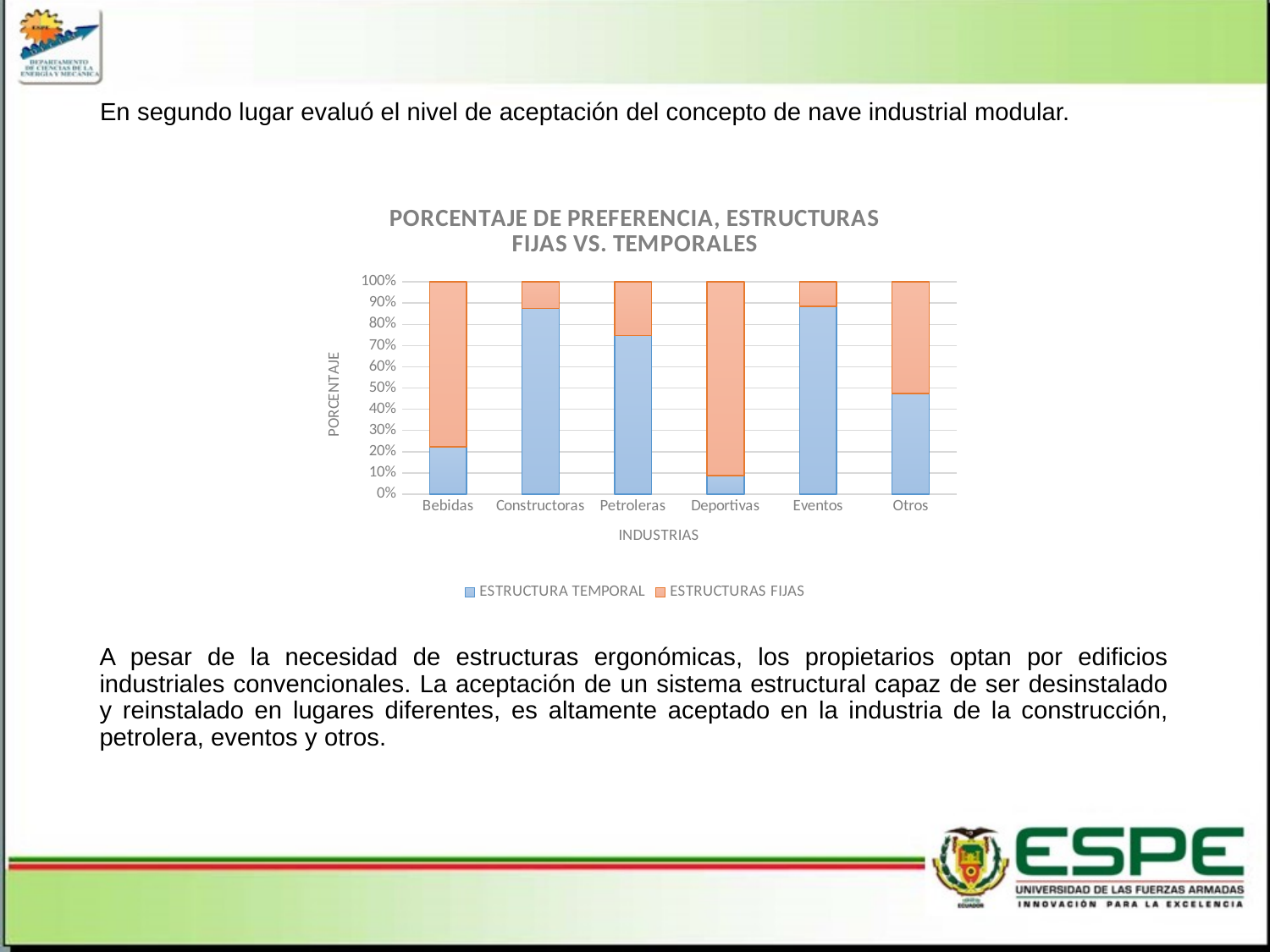
Is the ESTRUCTURA TEMPORAL share for Bebidas greater or less than 30%? less Is the ESTRUCTURA TEMPORAL share for Otros greater or less than 40%? greater Which industry has the highest share of ESTRUCTURAS FIJAS? Deportivas How many series does the chart legend list? 2 What is the title of the chart? PORCENTAJE DE PREFERENCIA, ESTRUCTURAS FIJAS VS. TEMPORALES Is the ESTRUCTURA TEMPORAL share for Constructoras greater or less than 80%? greater What kind of chart is shown on the slide? Stacked bar chart Which has a larger ESTRUCTURA TEMPORAL share, Bebidas or Petroleras? Petroleras What is the total height of each stacked bar in the chart? 100% How many industries are shown on the x axis of the chart? 6 Which industry has the lowest share of ESTRUCTURA TEMPORAL? Deportivas